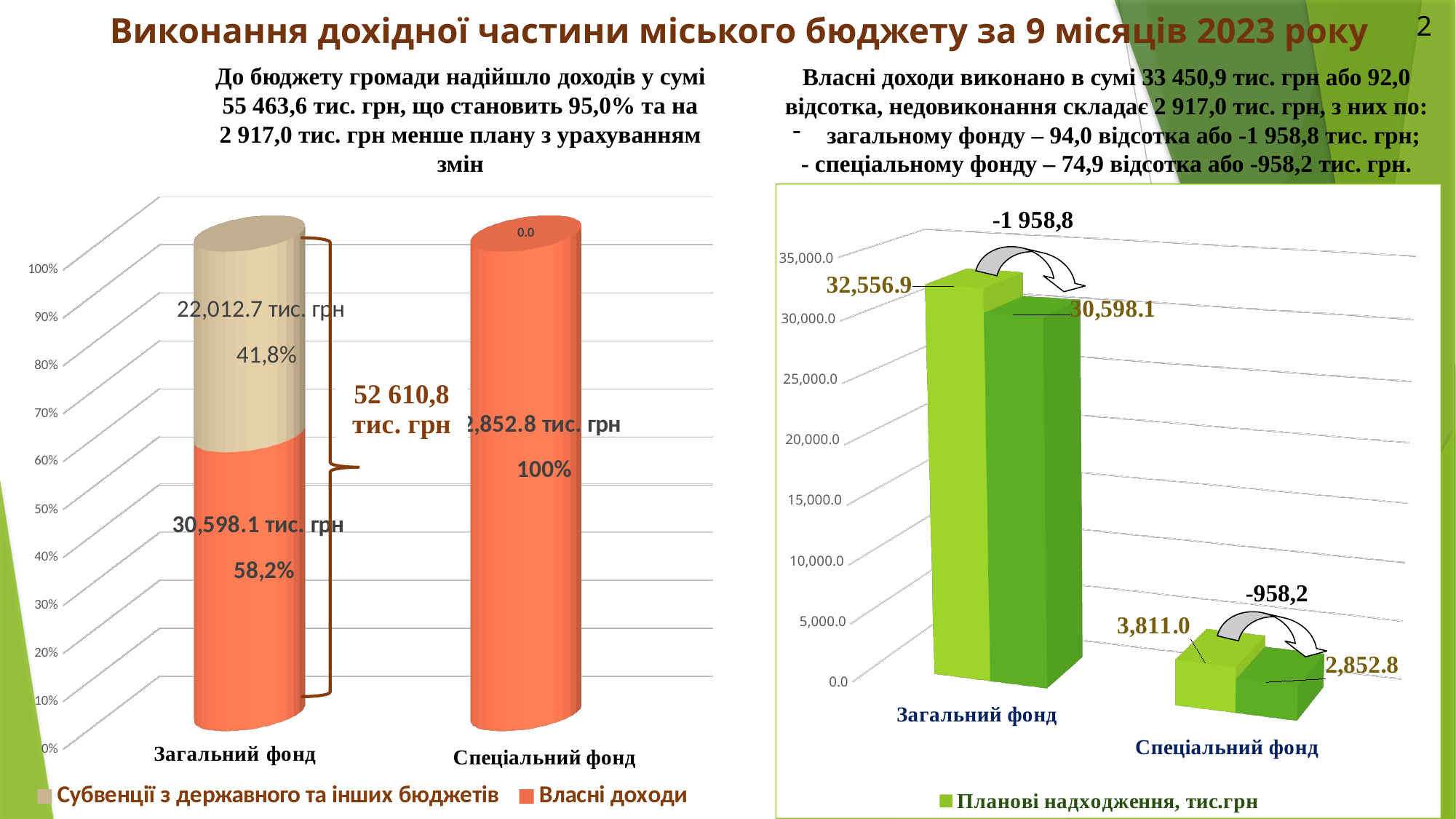
How many categories are shown on the x axis of the left chart? 2 In the right chart, what is the difference between the planned and actual values for Загальний фонд, as labelled above the arrow? -1 958,8 In the left chart, what is the value of Власні доходи for Загальний фонд? 30,598.1 тис. грн In the right chart, which category has the higher planned revenue, Загальний фонд or Спеціальний фонд? Загальний фонд How many series does the legend of the left chart list? 2 In the left chart, what is the value of Субвенції з державного та інших бюджетів for Загальний фонд? 22,012.7 тис. грн In the left chart, what percentage share do Субвенції з державного та інших бюджетів make up of Загальний фонд? 41,8% In the left chart, what percentage share do Власні доходи make up of Загальний фонд? 58,2% In the right chart, what is the planned revenue (Планові надходження) for Загальний фонд? 32,556.9 In the right chart, what is the planned revenue (Планові надходження) for Спеціальний фонд? 3,811.0 What type of chart is the right chart? Bar chart In the left chart, what is the value of Власні доходи for Спеціальний фонд? 2,852.8 тис. грн